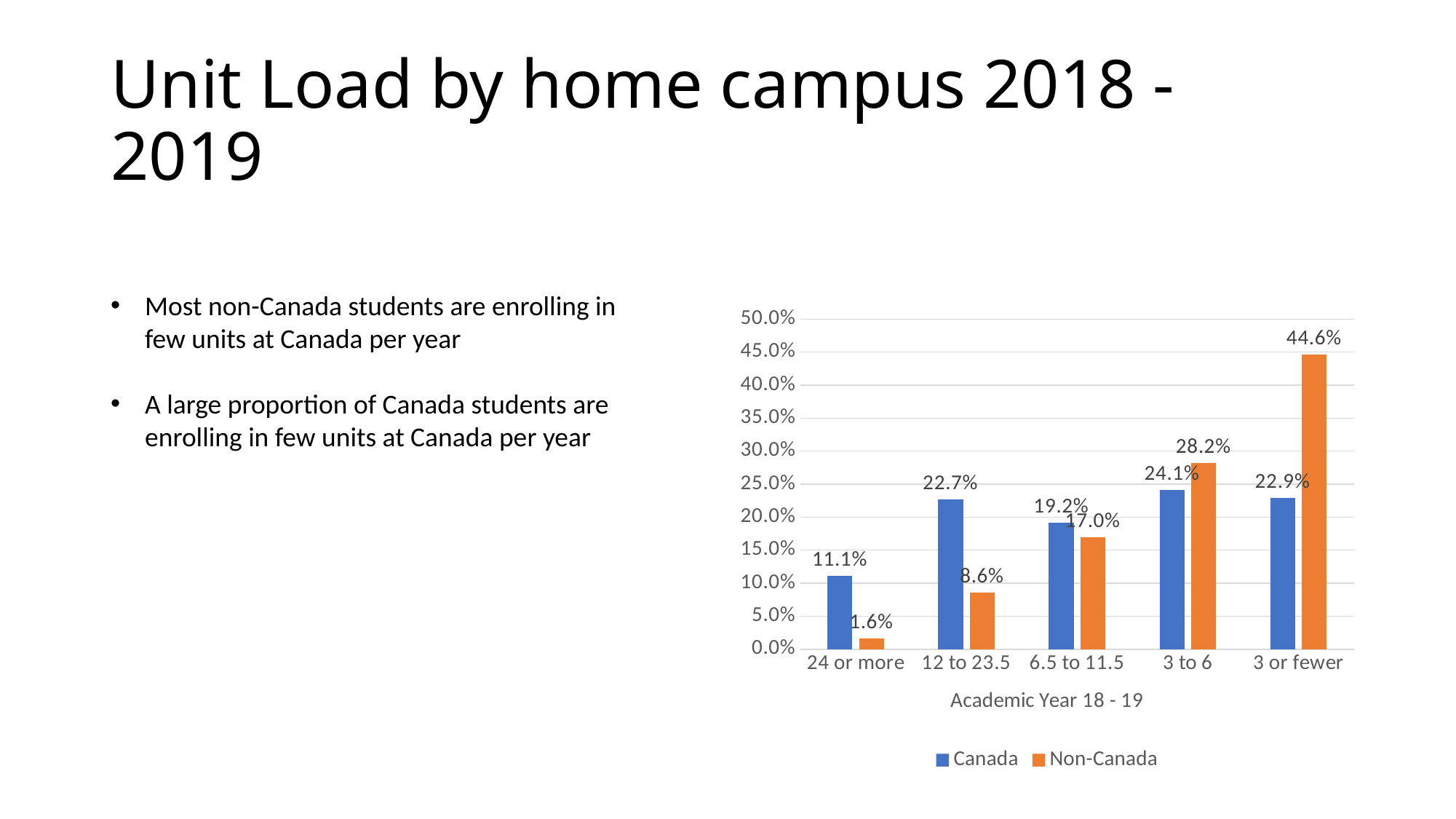
What is the Non-Canada value for the "12 to 23.5" category? 8.6% Is the Non-Canada value for "3 to 6" greater or less than 25.0%? greater What is the Non-Canada value for the "3 or fewer" unit load category? 44.6% How many unit load categories are shown on the x axis? 5 For the "6.5 to 11.5" category, which series has the larger value, Canada or Non-Canada? Canada What is the x-axis title of the chart? Academic Year 18 - 19 What is the difference between the Non-Canada and Canada values for the "3 or fewer" category? 21.7% Which unit load category has the lowest Non-Canada value? 24 or more What kind of chart is shown on the slide? Bar chart Which unit load category has the highest Canada value? 3 to 6 How many series does the legend list? 2 What is the Canada value for the "24 or more" unit load category? 11.1%